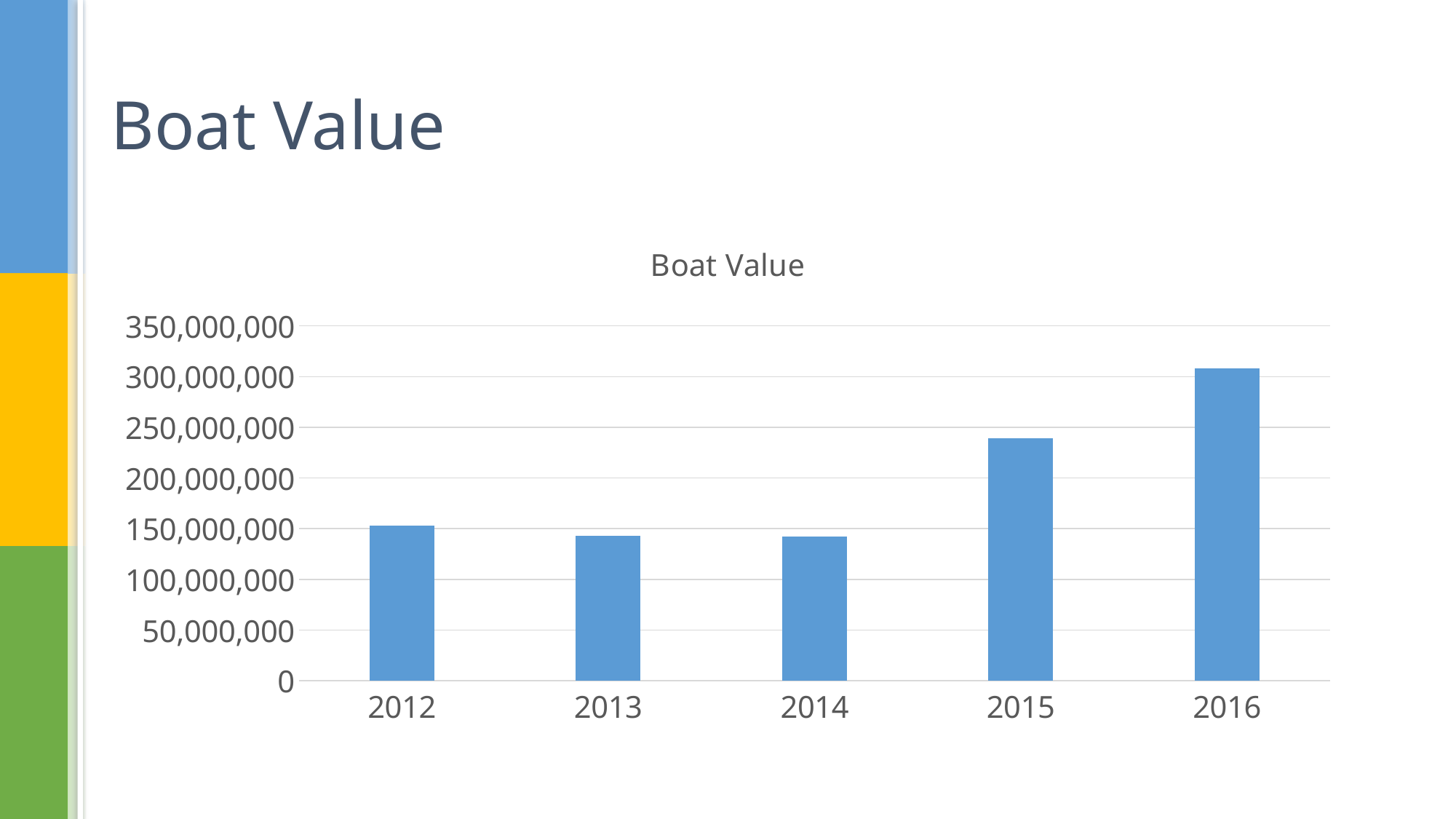
Which year has the highest boat value? 2016 Is the boat value for 2013 greater or less than 150,000,000? less What is the highest value shown on the vertical axis of the chart? 350,000,000 What type of chart is shown on the slide? Bar chart Is the boat value for 2014 greater or less than 100,000,000? greater Is the boat value for 2015 greater or less than 200,000,000? greater Which is larger, the boat value for 2016 or for 2015? 2016 How many years are shown on the x axis of the chart? 5 What is the title of the chart? Boat Value Does the boat value rise or fall from 2014 to 2016? rise Which is larger, the boat value for 2015 or for 2012? 2015